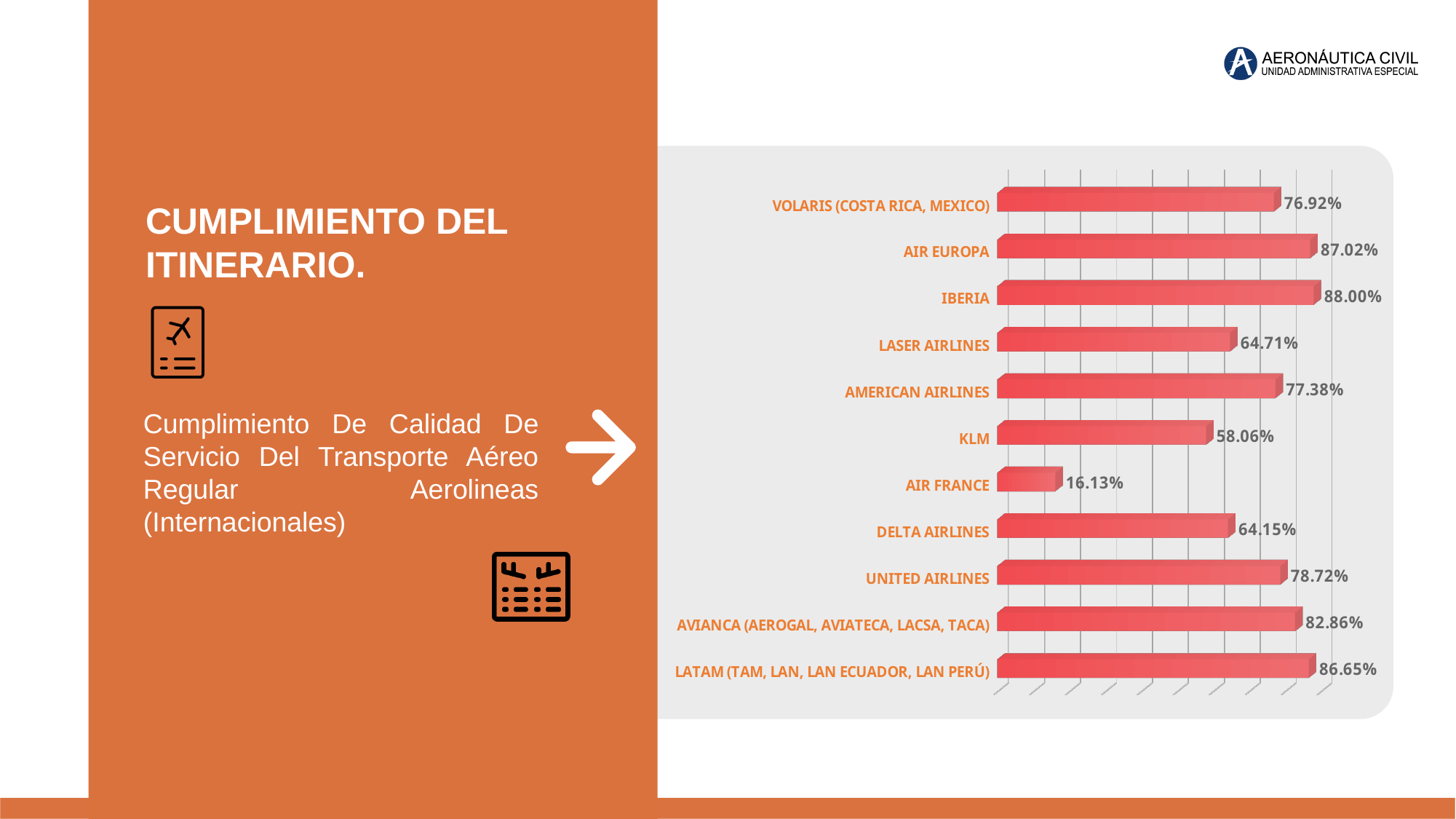
Which has a larger value, AMERICAN AIRLINES or LASER AIRLINES? AMERICAN AIRLINES Which airline has the highest value? IBERIA What is the value for KLM? 58.06% What is the difference between the values for UNITED AIRLINES and DELTA AIRLINES? 14.57 percentage points What is the value for AIR FRANCE? 16.13% What kind of chart is shown on the slide? Bar chart What is the value for IBERIA? 88.00% How many airlines are shown in the chart? 11 What is the difference between the values for IBERIA and AIR EUROPA? 0.98 percentage points Which airline has the lowest value? AIR FRANCE What is the value for AVIANCA (AEROGAL, AVIATECA, LACSA, TACA)? 82.86% Which has a larger value, AIR EUROPA or LATAM (TAM, LAN, LAN ECUADOR, LAN PERÚ)? AIR EUROPA